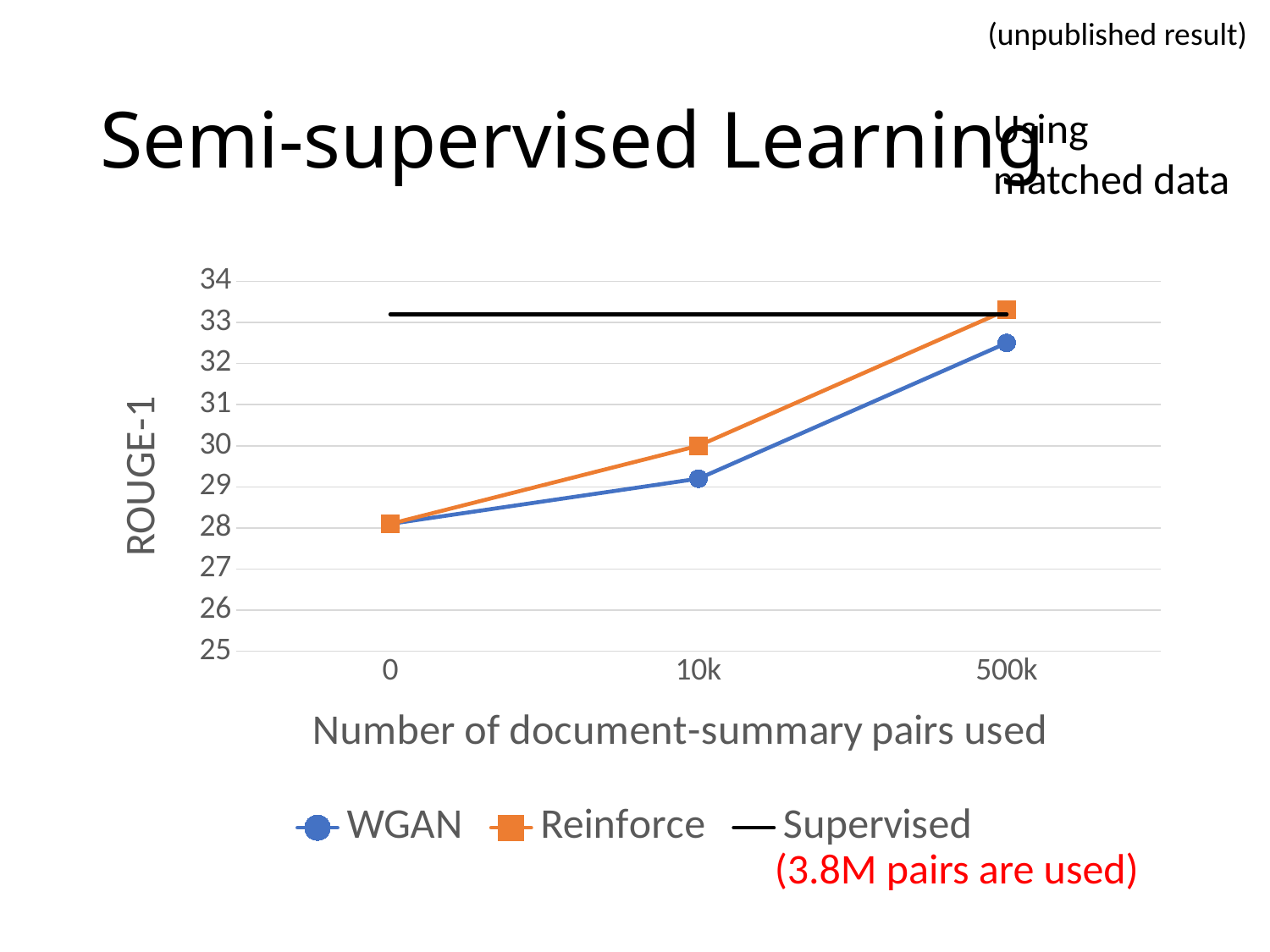
What is the title of the y axis? ROUGE-1 At 10k document-summary pairs, which series has the higher ROUGE-1, WGAN or Reinforce? Reinforce At 500k document-summary pairs, which series has the higher ROUGE-1, WGAN or Reinforce? Reinforce Is the WGAN value at 0 greater or less than 29? less What kind of chart is shown on the slide? line chart At which number of document-summary pairs does WGAN reach its highest ROUGE-1? 500k How many categories are shown on the x axis? 3 Is the WGAN value at 500k greater or less than 32? greater Is the WGAN value at 10k greater or less than 30? less Do the WGAN values rise or fall as the number of document-summary pairs increases? rise How many series does the legend list? 3